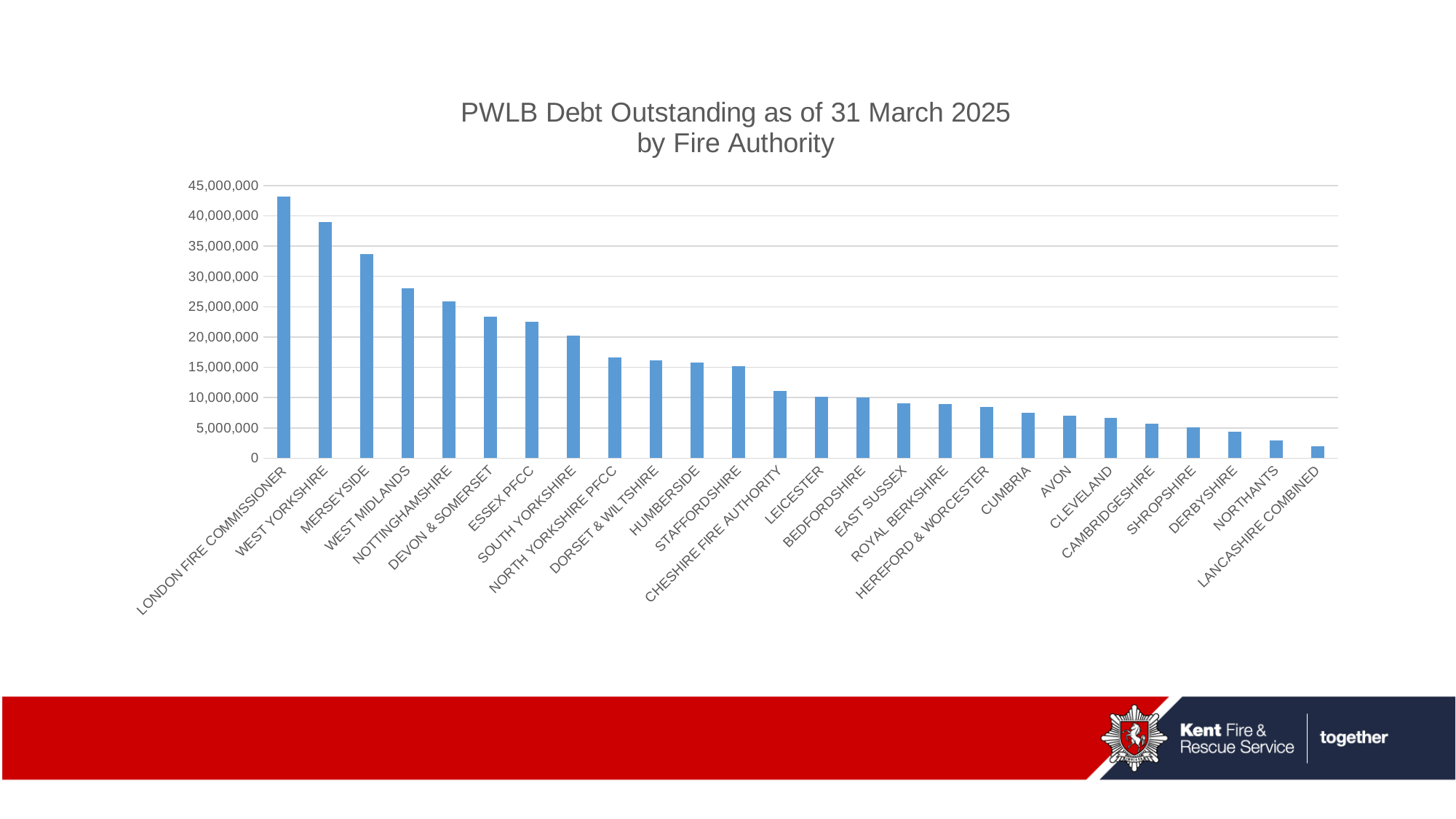
Is the value for DEVON & SOMERSET greater or less than 25,000,000? less What is the title of the chart? PWLB Debt Outstanding as of 31 March 2025 by Fire Authority Is the value for NORTHANTS greater or less than 5,000,000? less What type of chart is shown on the slide? bar chart Which fire authority has the highest PWLB debt outstanding? LONDON FIRE COMMISSIONER How many fire authorities are shown on the chart? 26 Is the value for LONDON FIRE COMMISSIONER greater or less than 40,000,000? greater Do the values rise or fall moving from left to right along the x axis? fall Which has a larger PWLB debt outstanding, MERSEYSIDE or WEST MIDLANDS? MERSEYSIDE Which has a larger PWLB debt outstanding, CUMBRIA or SHROPSHIRE? CUMBRIA Which fire authority has the lowest PWLB debt outstanding? LANCASHIRE COMBINED